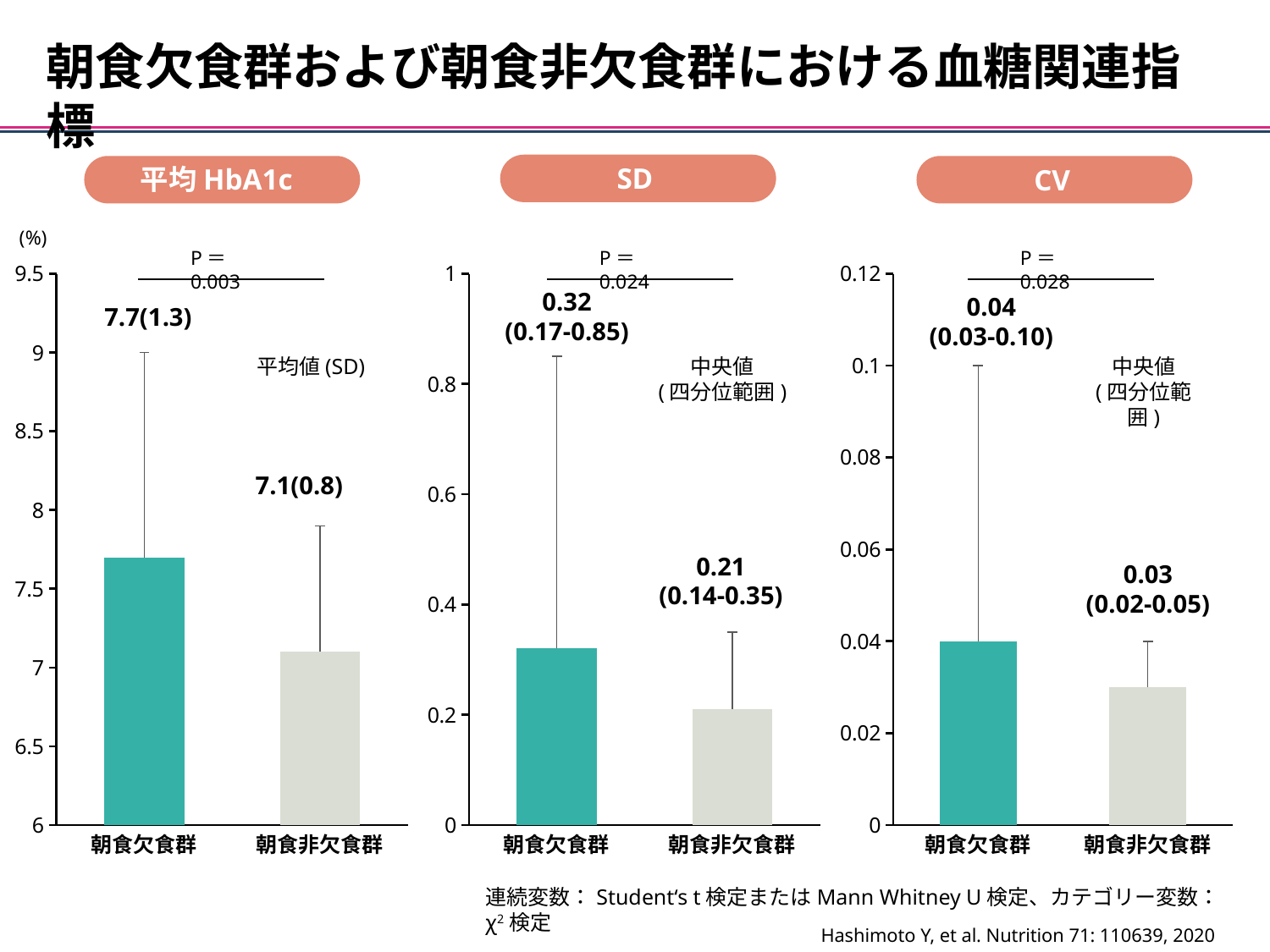
In the SD chart, what is the median value shown for 朝食欠食群? 0.32 What P value is shown above the bars in the CV chart? P = 0.028 In the 平均 HbA1c chart, what value label is shown for 朝食非欠食群? 7.1(0.8) In the 平均 HbA1c chart, what value label is shown for 朝食欠食群? 7.7(1.3) In the CV chart, what is the median value shown for 朝食非欠食群? 0.03 In the SD chart, which group has the higher bar? 朝食欠食群 In the 平均 HbA1c chart, is the bar for 朝食非欠食群 greater or less than 7.5? less In the CV chart, which group has the lower bar? 朝食非欠食群 What kind of chart is used in the SD panel? bar chart In the 平均 HbA1c chart, what is the difference between the mean values of 朝食欠食群 (7.7) and 朝食非欠食群 (7.1)? 0.6 In the SD chart, what is the interquartile range shown for 朝食非欠食群? 0.14-0.35 In the CV chart, what is the interquartile range shown for 朝食欠食群? 0.03-0.10